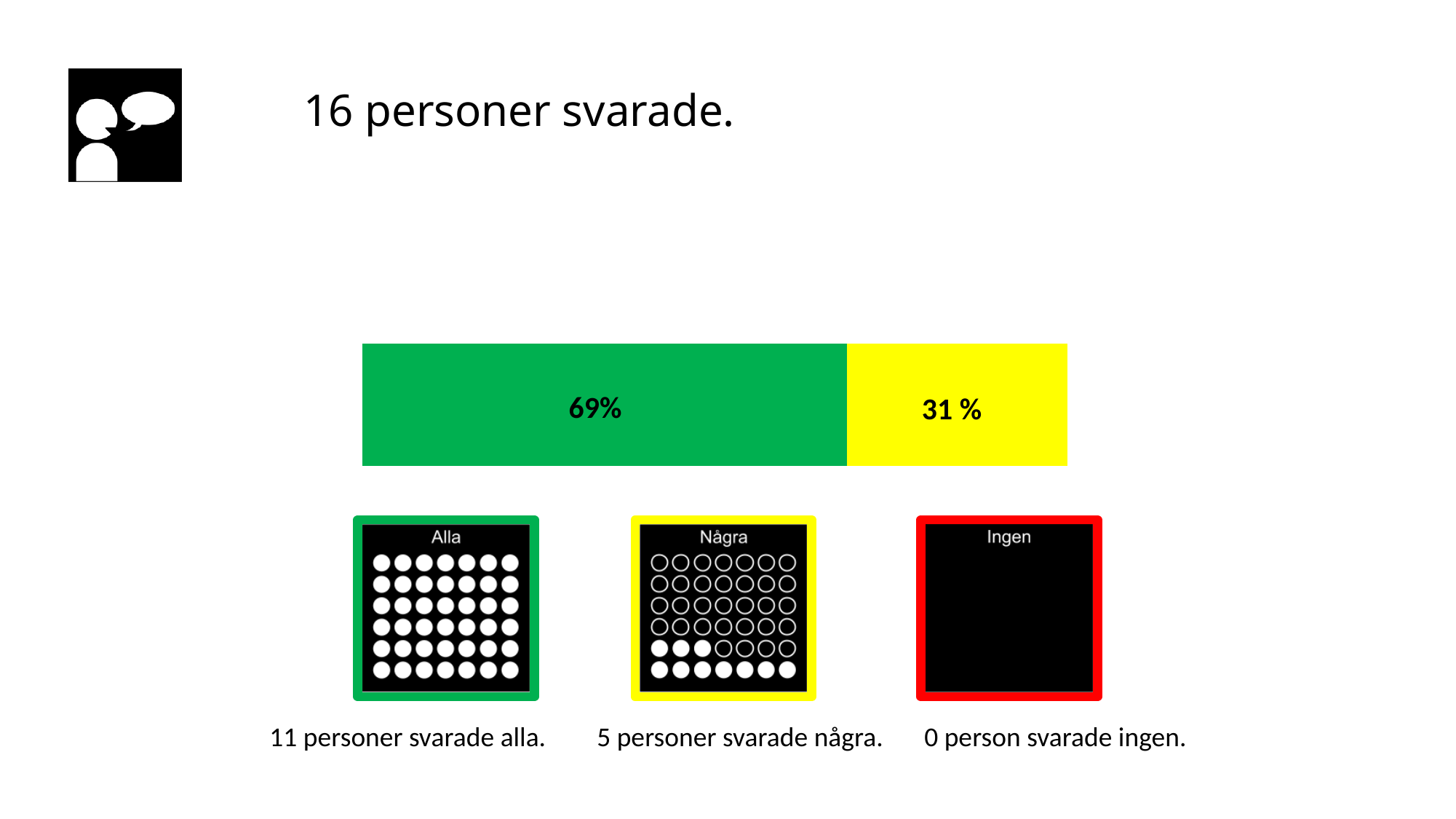
How many people answered 'ingen' according to the slide? 0 Which answer option received the fewest responses? Ingen What kind of chart is shown in the middle of the slide? bar chart Which answer option received the most responses? Alla Which segment of the bar is larger, the green one or the yellow one? the green one How many people answered 'några' according to the slide? 5 What is the difference in percentage points between the green segment (69%) and the yellow segment (31 %)? 38 How many people answered 'alla' according to the slide? 11 How many people answered in total according to the slide title? 16 What percentage is printed on the yellow segment of the bar? 31 % What percentage is printed on the green segment of the bar? 69% How many segments does the stacked bar have? 2